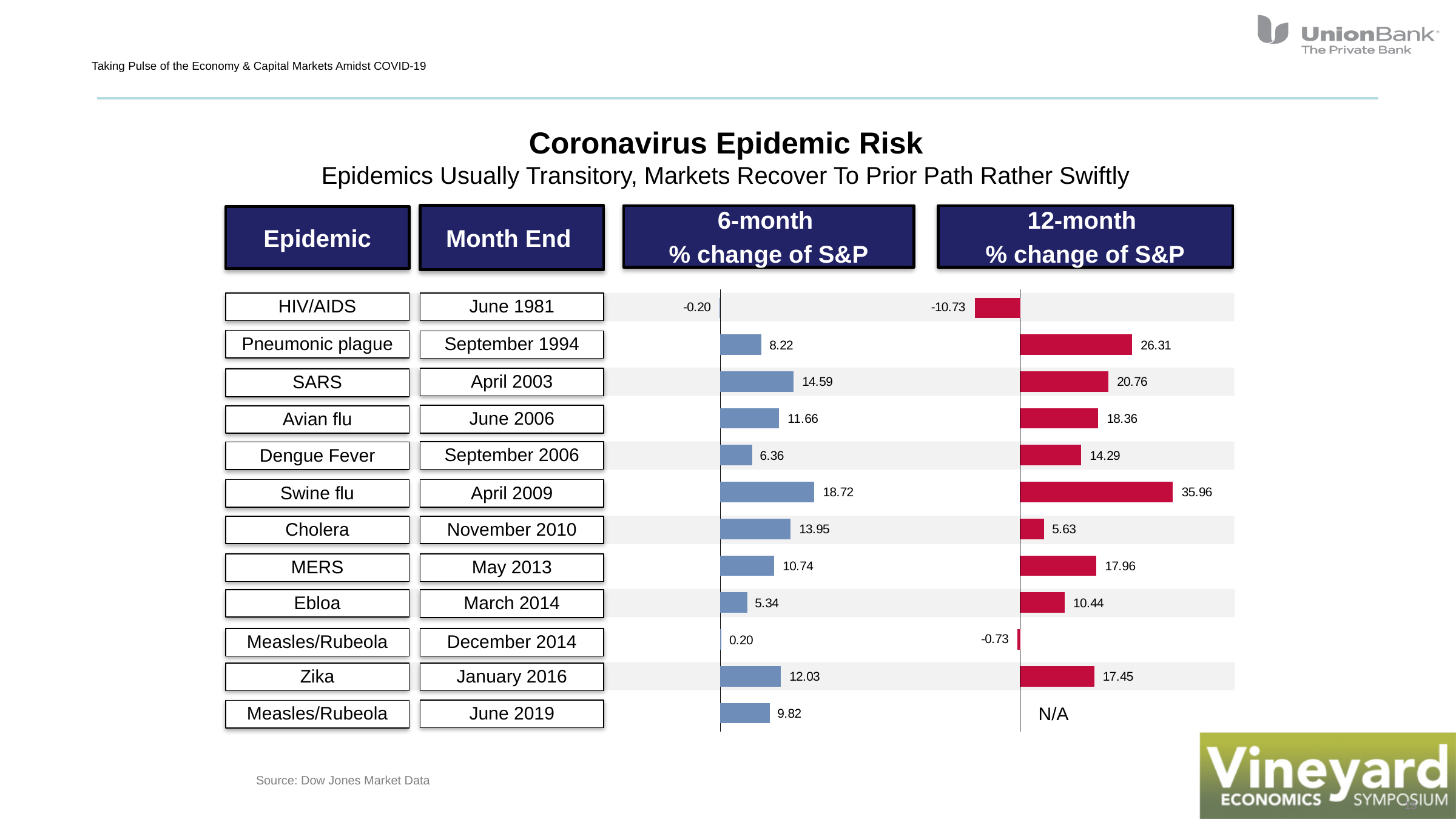
What kind of chart is used to show the 12-month % change of S&P? Bar chart In the 6-month % change of S&P chart, what is the value for Zika? 12.03 In the 12-month % change of S&P chart, what is the value for HIV/AIDS? -10.73 In the 12-month % change of S&P chart, which is larger: the value for Cholera or the value for Ebloa? Ebloa In the 12-month % change of S&P chart, which epidemic has the lowest value? HIV/AIDS In the 6-month % change of S&P chart, which is larger: the value for Avian flu or the value for MERS? Avian flu How many epidemics are listed in the 6-month % change of S&P chart? 12 What is the difference between the 12-month and 6-month % change of S&P for Swine flu? 17.24 In the 6-month % change of S&P chart, what is the value for SARS? 14.59 In the 12-month % change of S&P chart, what is the value for Pneumonic plague? 26.31 In the 12-month % change of S&P chart, which epidemic has the highest value? Swine flu In the 6-month % change of S&P chart, which epidemic has the highest value? Swine flu